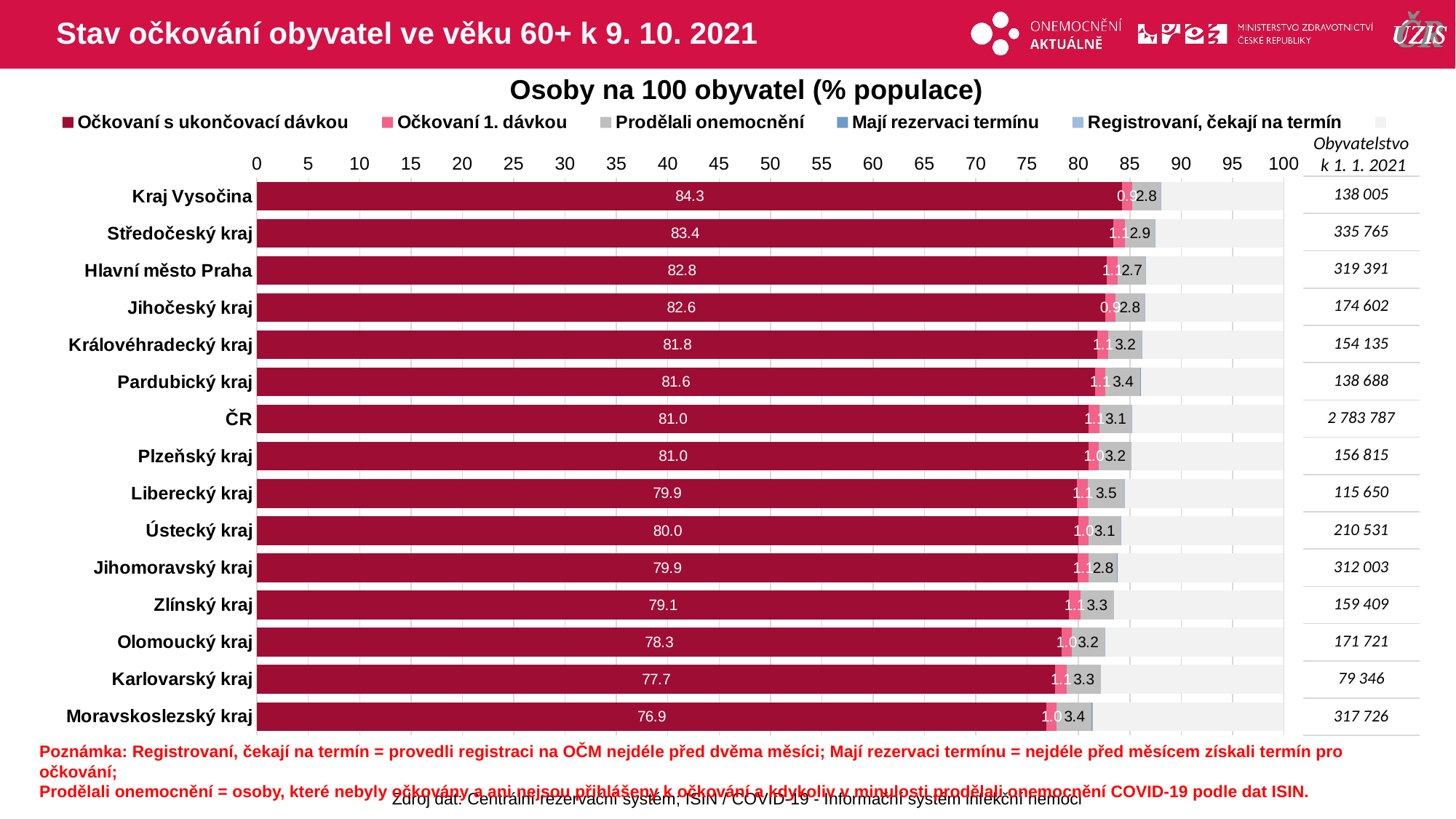
What is the value of "Očkovaní s ukončovací dávkou" for ČR? 81.0 Which region has the lowest value for "Očkovaní s ukončovací dávkou"? Moravskoslezský kraj What is the title of the chart? Osoby na 100 obyvatel (% populace) Which has a higher value for "Očkovaní s ukončovací dávkou": Olomoucký kraj or Karlovarský kraj? Olomoucký kraj What is the value of "Očkovaní s ukončovací dávkou" for Moravskoslezský kraj? 76.9 What is the difference in "Očkovaní s ukončovací dávkou" between Kraj Vysočina and Moravskoslezský kraj? 7.4 What is the value of "Očkovaní s ukončovací dávkou" for Kraj Vysočina? 84.3 Which region has the highest value for "Očkovaní s ukončovací dávkou"? Kraj Vysočina How many regions (categories) are shown on the chart? 15 What is the value of "Prodělali onemocnění" for Liberecký kraj? 3.5 Is the value of "Očkovaní s ukončovací dávkou" for Kraj Vysočina greater or less than 80? greater What type of chart is shown on the slide? Stacked bar chart